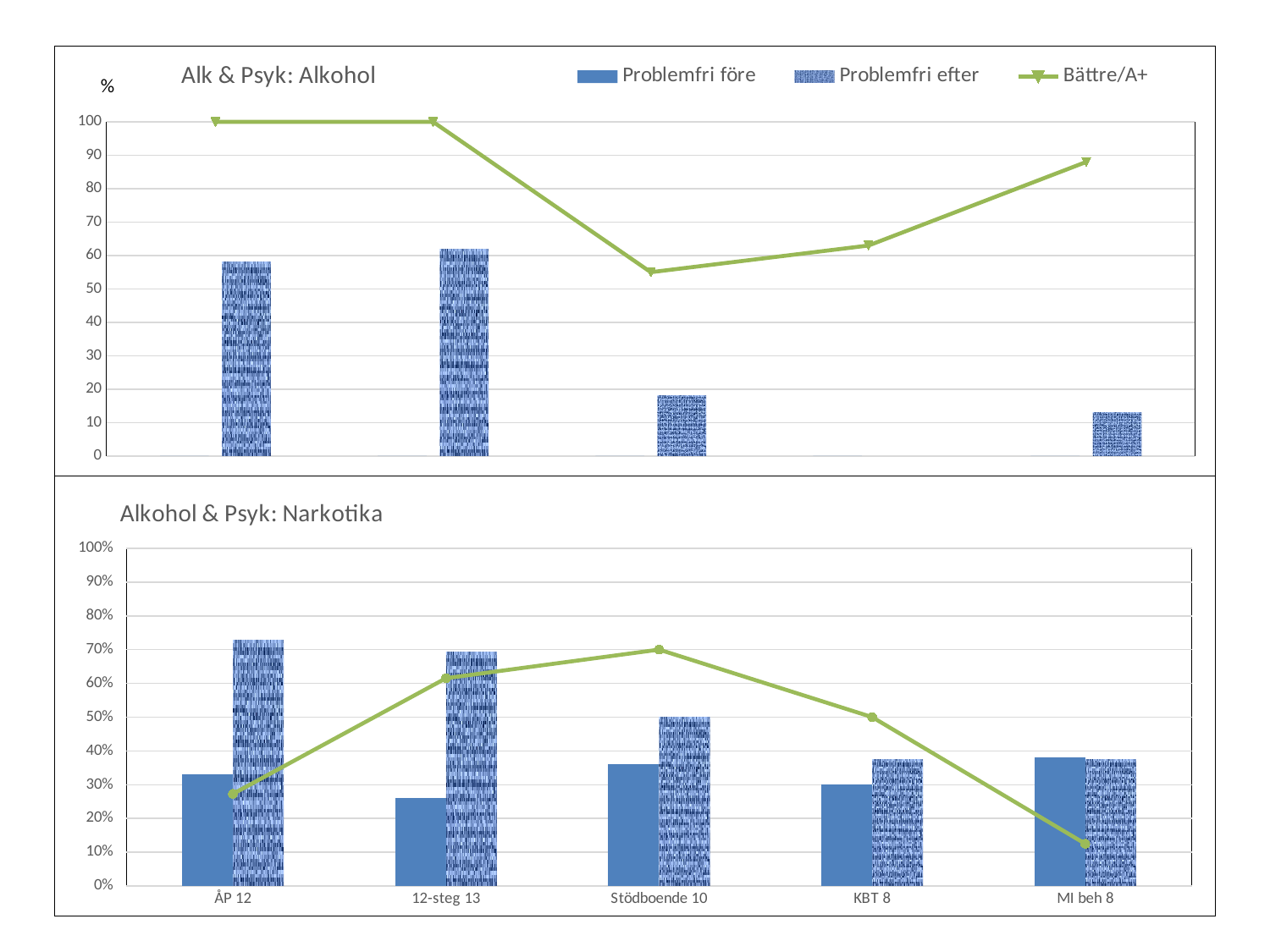
In the bottom chart (Alkohol & Psyk: Narkotika), which category has the lowest Problemfri före value? 12-steg 13 In the bottom chart (Alkohol & Psyk: Narkotika), is the Problemfri före value for 12-steg 13 greater or less than 30%? less What kind of chart is the top chart (Alk & Psyk: Alkohol)? Combination bar and line chart In the top chart (Alk & Psyk: Alkohol), what is the value of the first Bättre/A+ point? 100 In the bottom chart (Alkohol & Psyk: Narkotika), which category has the lowest Bättre/A+ value? MI beh 8 In the bottom chart (Alkohol & Psyk: Narkotika), how many categories are shown on the x axis? 5 In the bottom chart (Alkohol & Psyk: Narkotika), is the Bättre/A+ value for MI beh 8 greater or less than 20%? less What is the title of the bottom chart? Alkohol & Psyk: Narkotika In the bottom chart (Alkohol & Psyk: Narkotika), which category has the highest Bättre/A+ value? Stödboende 10 In the bottom chart (Alkohol & Psyk: Narkotika), which is larger for Stödboende 10: Problemfri före or Problemfri efter? Problemfri efter In the bottom chart (Alkohol & Psyk: Narkotika), is the Problemfri efter value for ÅP 12 greater or less than 70%? greater